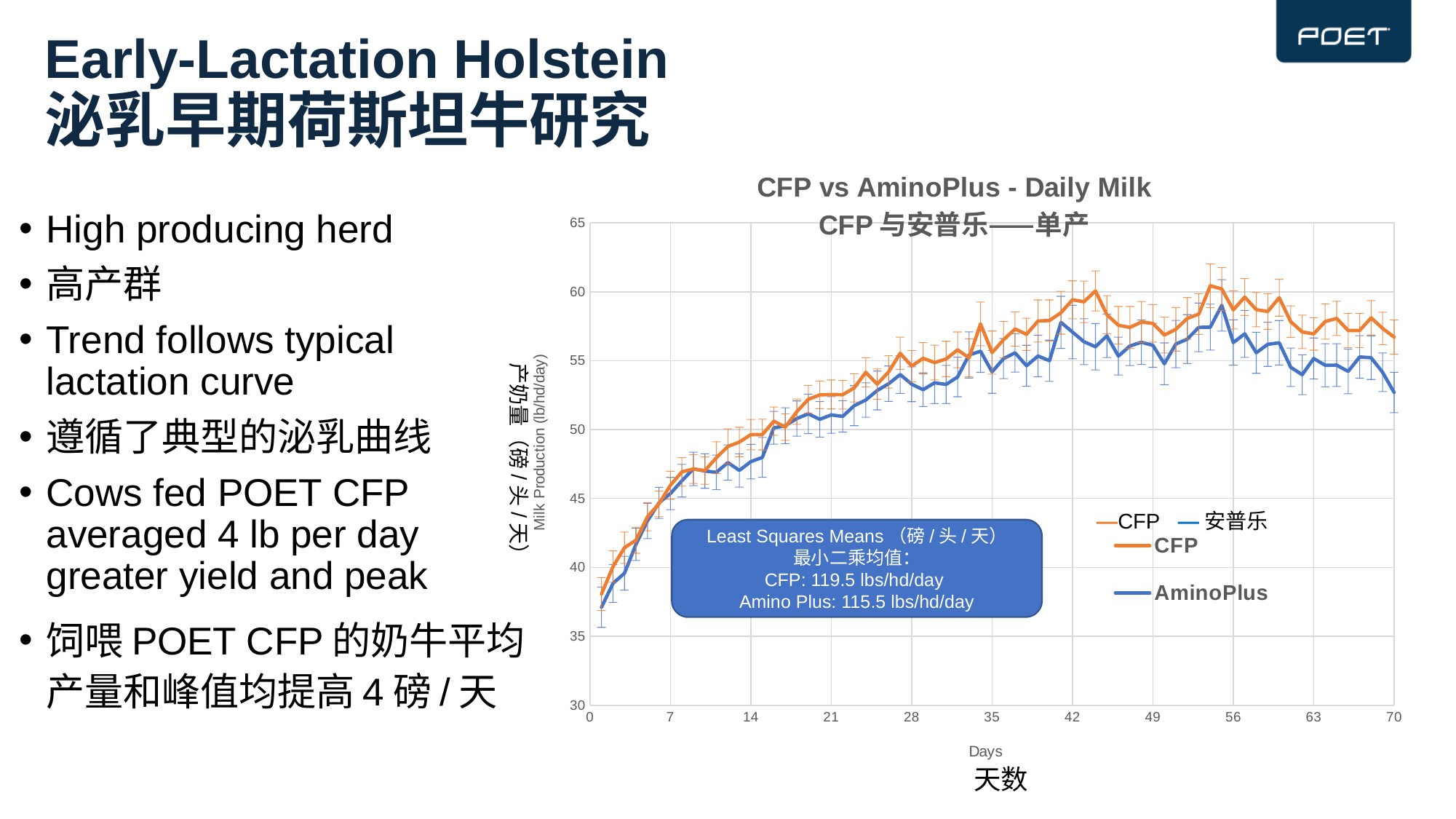
What is the title of the chart? CFP vs AminoPlus - Daily Milk CFP 与安普乐——单产 Is the CFP value at day 1 greater or less than 40? less What is the label on the x axis of the chart? Days Is the CFP value at day 42 greater or less than 55? greater Is the AminoPlus value at day 70 greater or less than 55? less What kind of chart is shown on the slide? line chart Between day 0 and day 28, do the CFP values rise or fall along the x axis? rise Which series reaches the highest daily milk production on the chart? CFP What is the highest tick value shown on the y axis? 65 How many series does the chart's legend list? 2 At day 42, which series has the higher value, CFP or AminoPlus? CFP